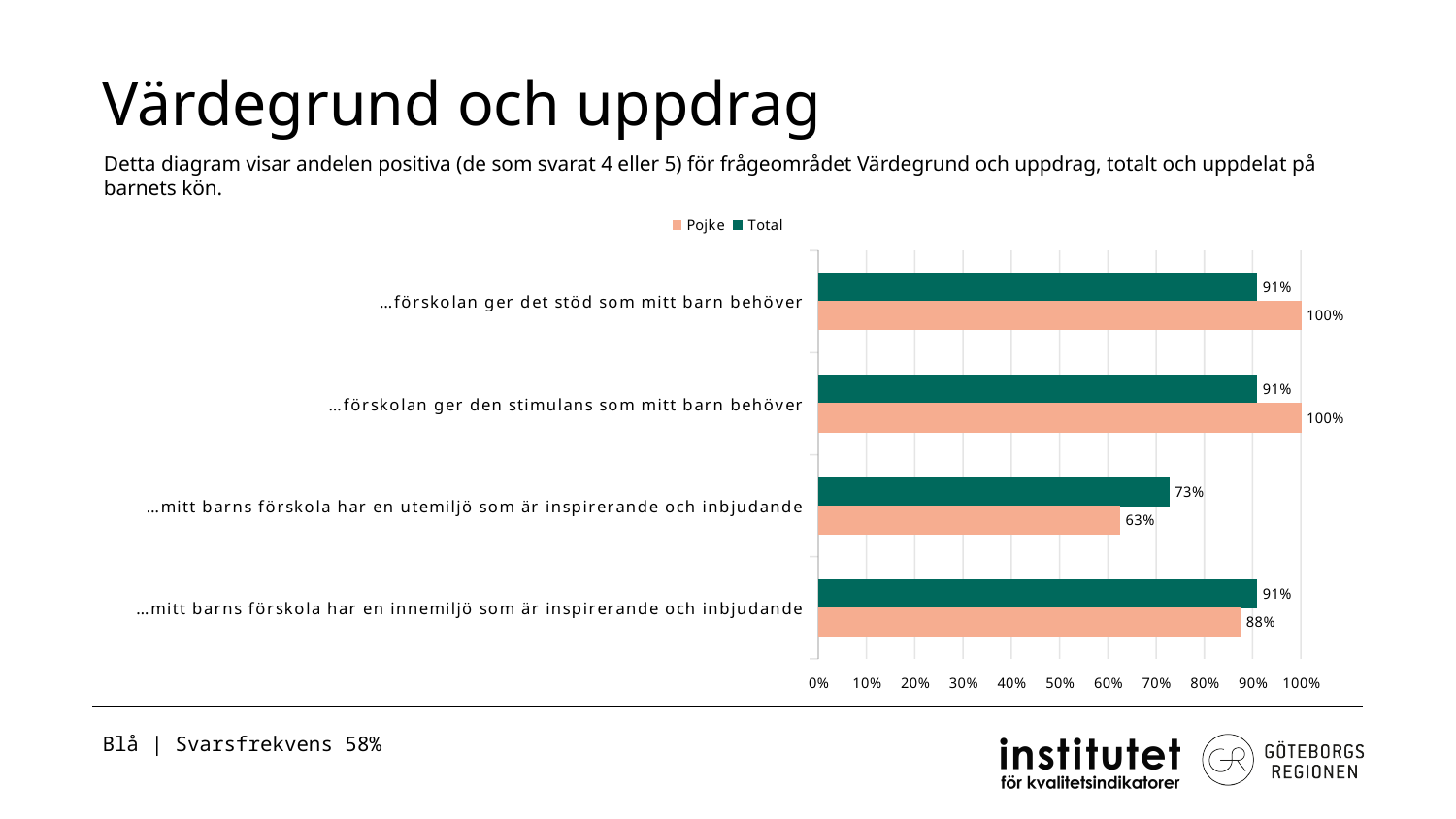
Which category has the lowest Pojke value? …mitt barns förskola har en utemiljö som är inspirerande och inbjudande What is the difference between the Pojke and Total values for "…förskolan ger det stöd som mitt barn behöver"? 9% What is the difference between the Total and Pojke values for "…mitt barns förskola har en utemiljö som är inspirerande och inbjudande"? 10% For "…mitt barns förskola har en innemiljö som är inspirerande och inbjudande", which is larger, the Pojke value or the Total value? Total What is the Total value for "…förskolan ger den stimulans som mitt barn behöver"? 91% What is the Pojke value for "…mitt barns förskola har en innemiljö som är inspirerande och inbjudande"? 88% What is the Total value for "…mitt barns förskola har en utemiljö som är inspirerande och inbjudande"? 73% Which category has the lowest Total value? …mitt barns förskola har en utemiljö som är inspirerande och inbjudande How many series does the legend list? 2 What is the Pojke value for "…förskolan ger det stöd som mitt barn behöver"? 100% What kind of chart is shown on the slide? Bar chart How many categories are shown in the chart? 4